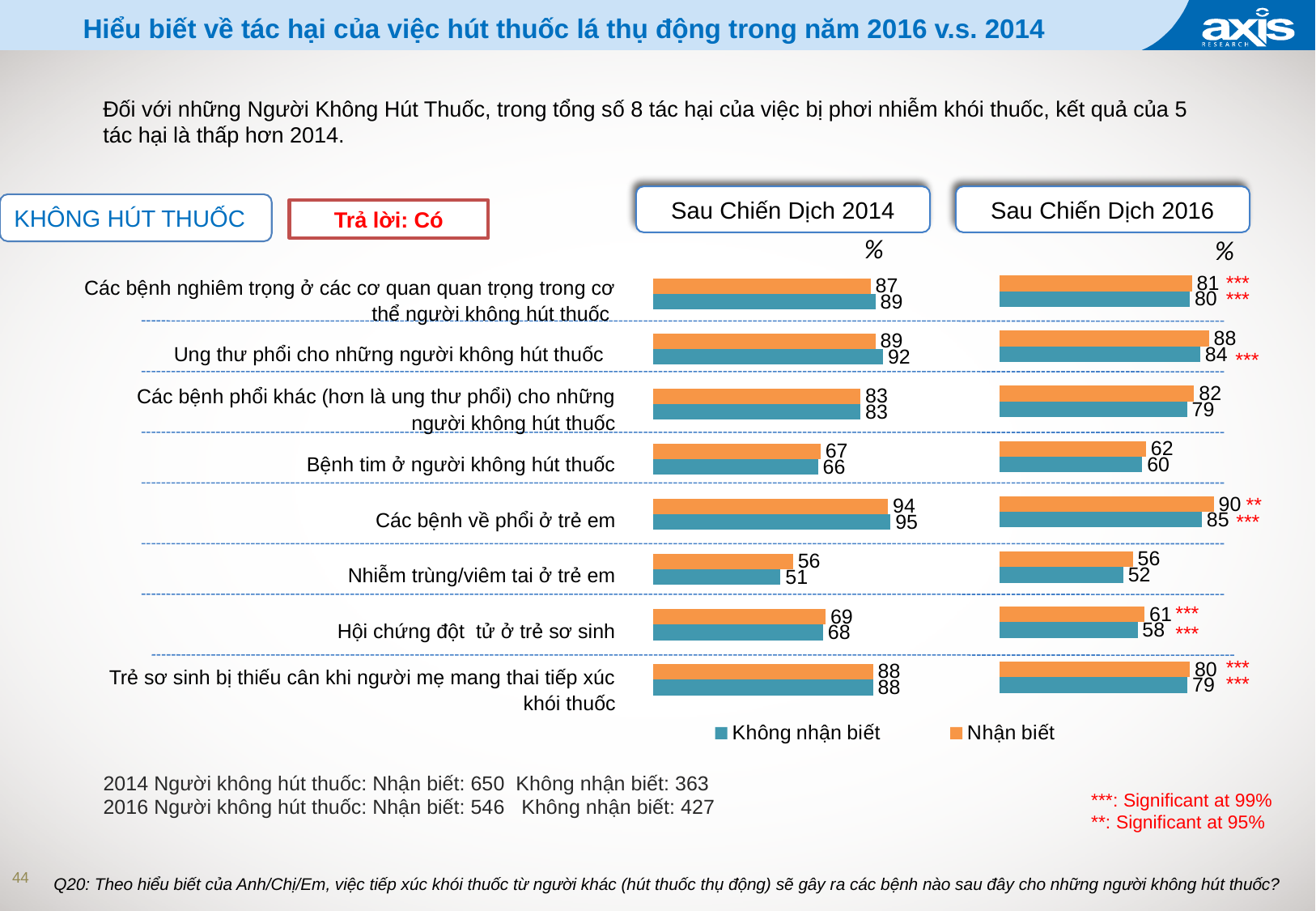
Which colour represents 'Nhận biết' in the charts? Orange In the 'Sau Chiến Dịch 2016' chart, what is the value for 'Không nhận biết' for 'Ung thư phổi cho những người không hút thuốc'? 84 In the 'Sau Chiến Dịch 2016' chart, what is the value for 'Nhận biết' for 'Hội chứng đột tử ở trẻ sơ sinh'? 61 In the 'Sau Chiến Dịch 2014' chart, which category has the lowest 'Không nhận biết' value? Nhiễm trùng/viêm tai ở trẻ em What type of chart is the 'Sau Chiến Dịch 2014' chart? Bar chart In the 'Sau Chiến Dịch 2016' chart, what is the difference between the 'Nhận biết' and 'Không nhận biết' values for 'Các bệnh về phổi ở trẻ em'? 5 How many categories are shown in the 'Sau Chiến Dịch 2016' chart? 8 For 'Bệnh tim ở người không hút thuốc', is the 'Nhận biết' value larger in the 'Sau Chiến Dịch 2014' chart or the 'Sau Chiến Dịch 2016' chart? Sau Chiến Dịch 2014 In the 'Sau Chiến Dịch 2014' chart, what is the value for 'Nhận biết' for 'Các bệnh về phổi ở trẻ em'? 94 In the 'Sau Chiến Dịch 2014' chart, what is the difference between the 'Nhận biết' and 'Không nhận biết' values for 'Nhiễm trùng/viêm tai ở trẻ em'? 5 How many series does the legend list for the charts? 2 In the 'Sau Chiến Dịch 2016' chart, which category has the highest 'Nhận biết' value? Các bệnh về phổi ở trẻ em